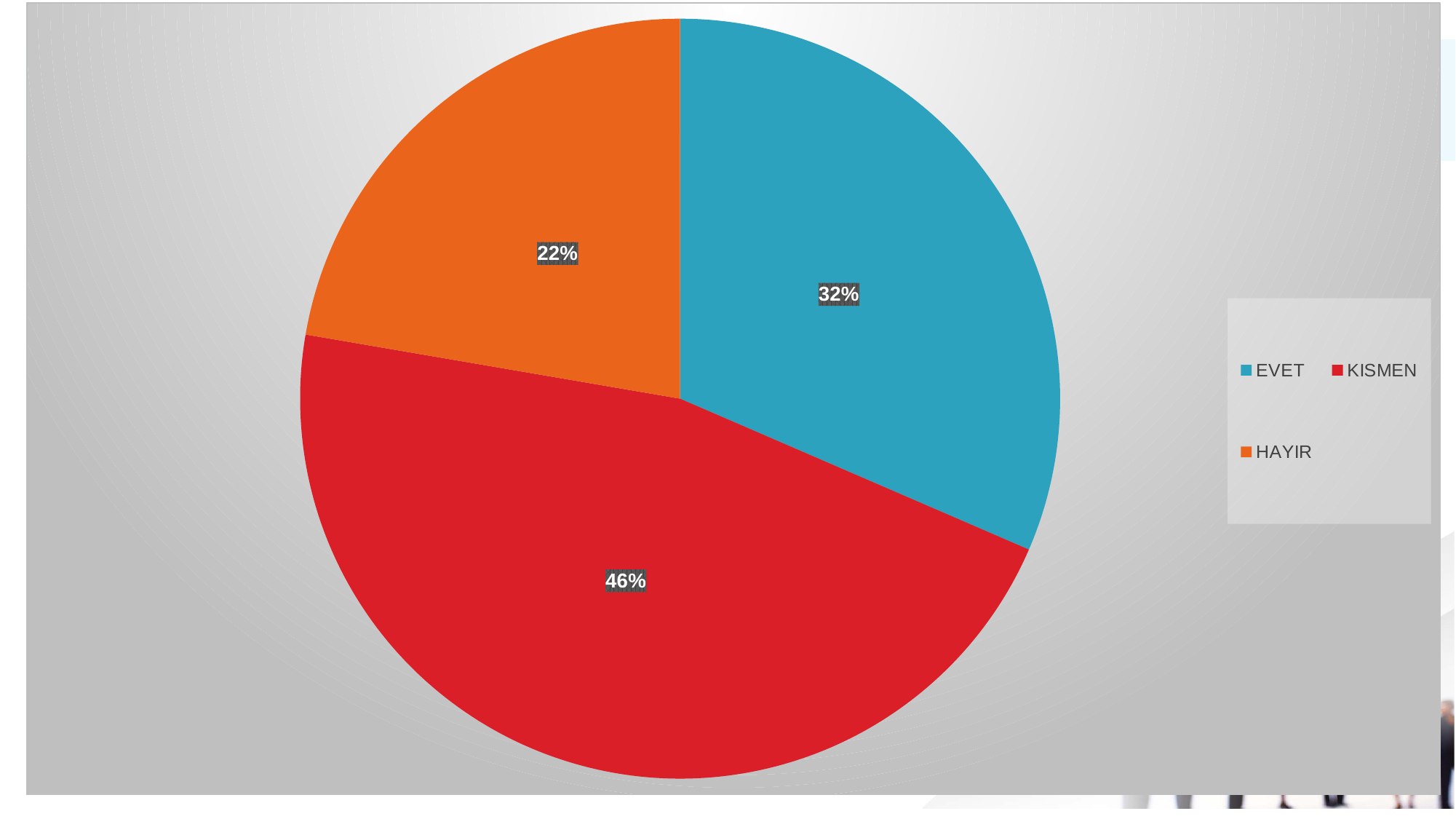
Which is larger, the EVET slice or the HAYIR slice? EVET What kind of chart is shown on the slide? Pie chart What colour is the KISMEN slice? Red What is the difference in percentage points between EVET and HAYIR? 10 What share of the pie does KISMEN represent? 46% What is the difference in percentage points between KISMEN and EVET? 14 Which category has the largest slice of the pie? KISMEN What share of the pie does EVET represent? 32% What share of the pie does HAYIR represent? 22% Which category has the smallest slice of the pie? HAYIR How many slices does the pie chart have? 3 How many entries does the legend list? 3